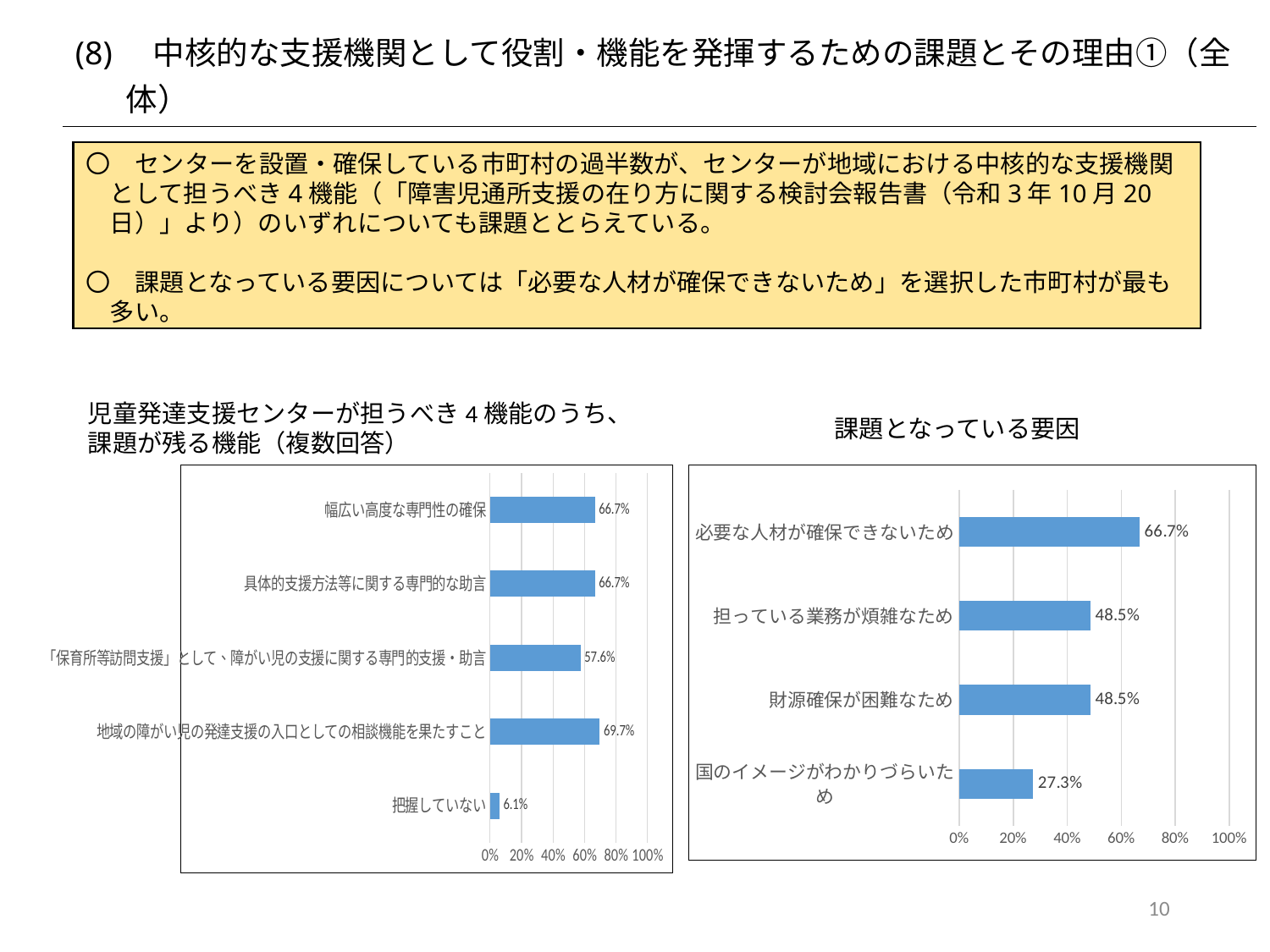
In the left chart (児童発達支援センターが担うべき4機能のうち、課題が残る機能), which category has the highest value? 地域の障がい児の発達支援の入口としての相談機能を果たすこと In the right chart (課題となっている要因), how many categories are shown? 4 In the left chart (児童発達支援センターが担うべき4機能のうち、課題が残る機能), what is the value for 把握していない? 6.1% What type of chart is the right chart (課題となっている要因)? Bar chart In the right chart (課題となっている要因), what is the value for 国のイメージがわかりづらいため? 27.3% In the left chart (児童発達支援センターが担うべき4機能のうち、課題が残る機能), how many categories are shown? 5 In the left chart (児童発達支援センターが担うべき4機能のうち、課題が残る機能), which category has the lowest value? 把握していない In the left chart (児童発達支援センターが担うべき4機能のうち、課題が残る機能), what is the value for 幅広い高度な専門性の確保? 66.7% In the left chart (児童発達支援センターが担うべき4機能のうち、課題が残る機能), what is the difference between 地域の障がい児の発達支援の入口としての相談機能を果たすこと and 「保育所等訪問支援」として、障がい児の支援に関する専門的支援・助言? 12.1% In the right chart (課題となっている要因), what is the value for 必要な人材が確保できないため? 66.7% In the right chart (課題となっている要因), which category has the highest value? 必要な人材が確保できないため In the right chart (課題となっている要因), what is the difference between 必要な人材が確保できないため and 担っている業務が煩雑なため? 18.2%